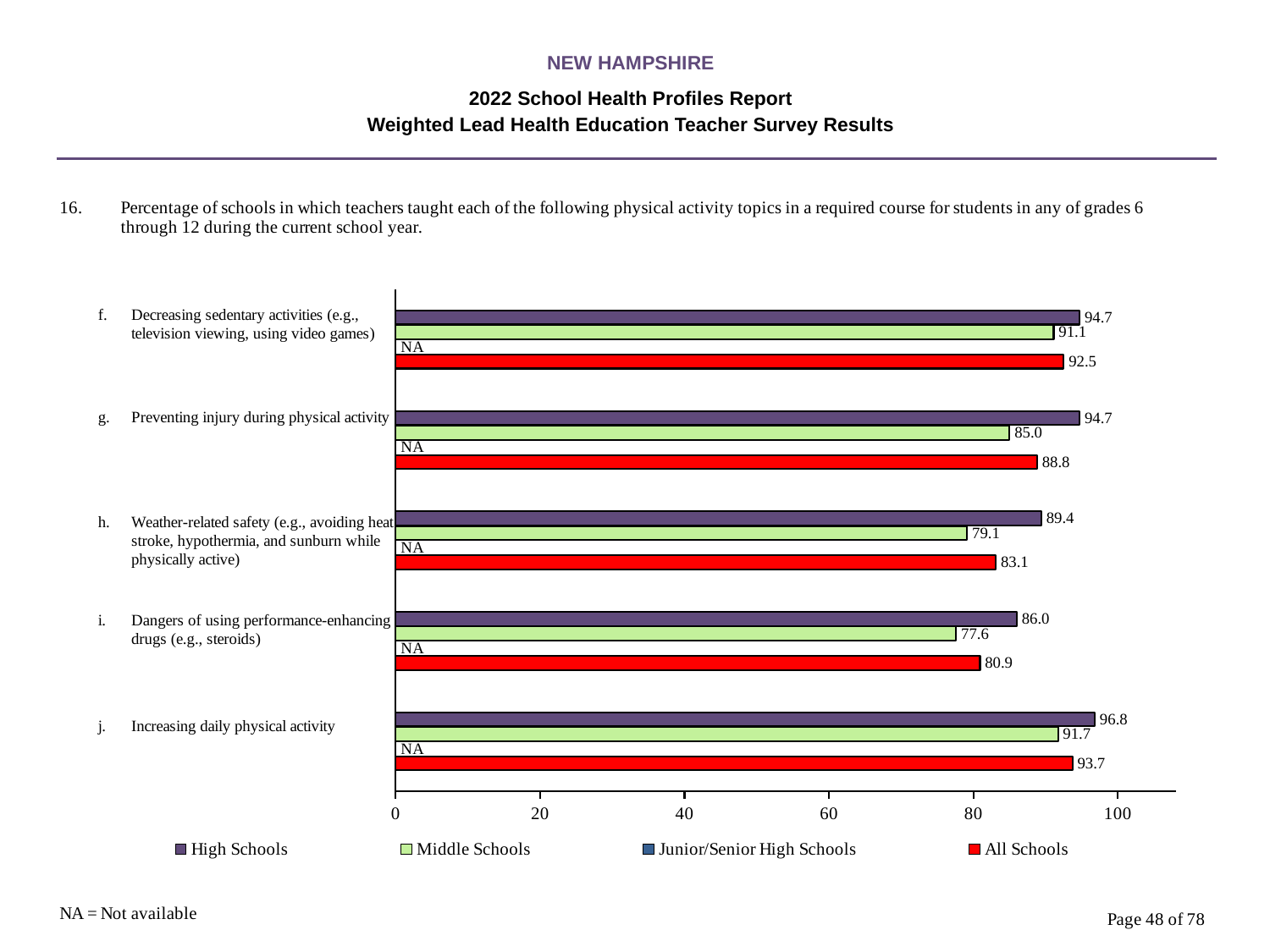
Which topic has the lowest value for Middle Schools? Dangers of using performance-enhancing drugs (e.g., steroids) What is the value for Junior/Senior High Schools for 'Dangers of using performance-enhancing drugs'? NA Is the All Schools value for 'Dangers of using performance-enhancing drugs' greater or less than 80? greater What is the value for High Schools for 'Increasing daily physical activity'? 96.8 What is the difference between the High Schools and Middle Schools values for 'Weather-related safety'? 10.3 What kind of chart is shown on the slide? bar chart What is the value for Middle Schools for 'Preventing injury during physical activity'? 85.0 How many physical activity topics are shown on the chart? 5 How many series does the legend list? 4 Which topic has the highest value for High Schools? Increasing daily physical activity What is the value for All Schools for 'Weather-related safety'? 83.1 Which is larger for 'Decreasing sedentary activities': the Middle Schools value or the All Schools value? All Schools